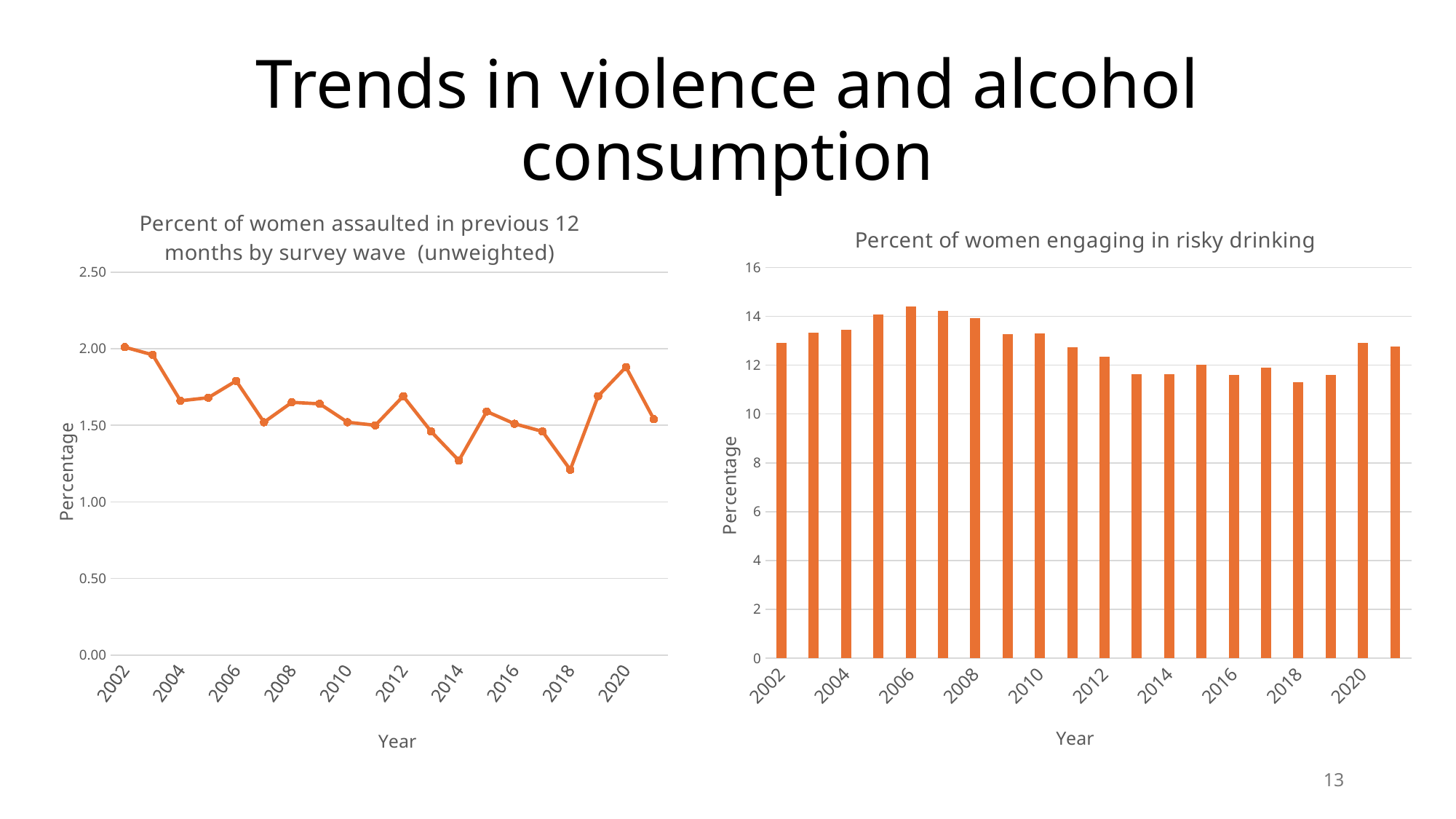
In the 'Percent of women engaging in risky drinking' chart, how many bars are plotted? 20 In the 'Percent of women assaulted in previous 12 months' chart, which is larger, the value for 2002 or the value for 2018? 2002 What kind of chart is the 'Percent of women engaging in risky drinking' chart on the right? bar chart In the 'Percent of women engaging in risky drinking' chart, which is larger, the value for 2006 or the value for 2018? 2006 What kind of chart is the 'Percent of women assaulted in previous 12 months by survey wave (unweighted)' chart on the left? line chart What is the label on the vertical axis of the 'Percent of women engaging in risky drinking' chart? Percentage In the 'Percent of women engaging in risky drinking' chart, is the value for 2018 greater or less than 12? less In the 'Percent of women assaulted in previous 12 months' chart, is the value for 2018 greater or less than 1.50? less In the 'Percent of women engaging in risky drinking' chart, do the values generally rise or fall from 2006 to 2018? fall In the 'Percent of women assaulted in previous 12 months' chart, is the value for 2020 greater or less than 1.50? greater